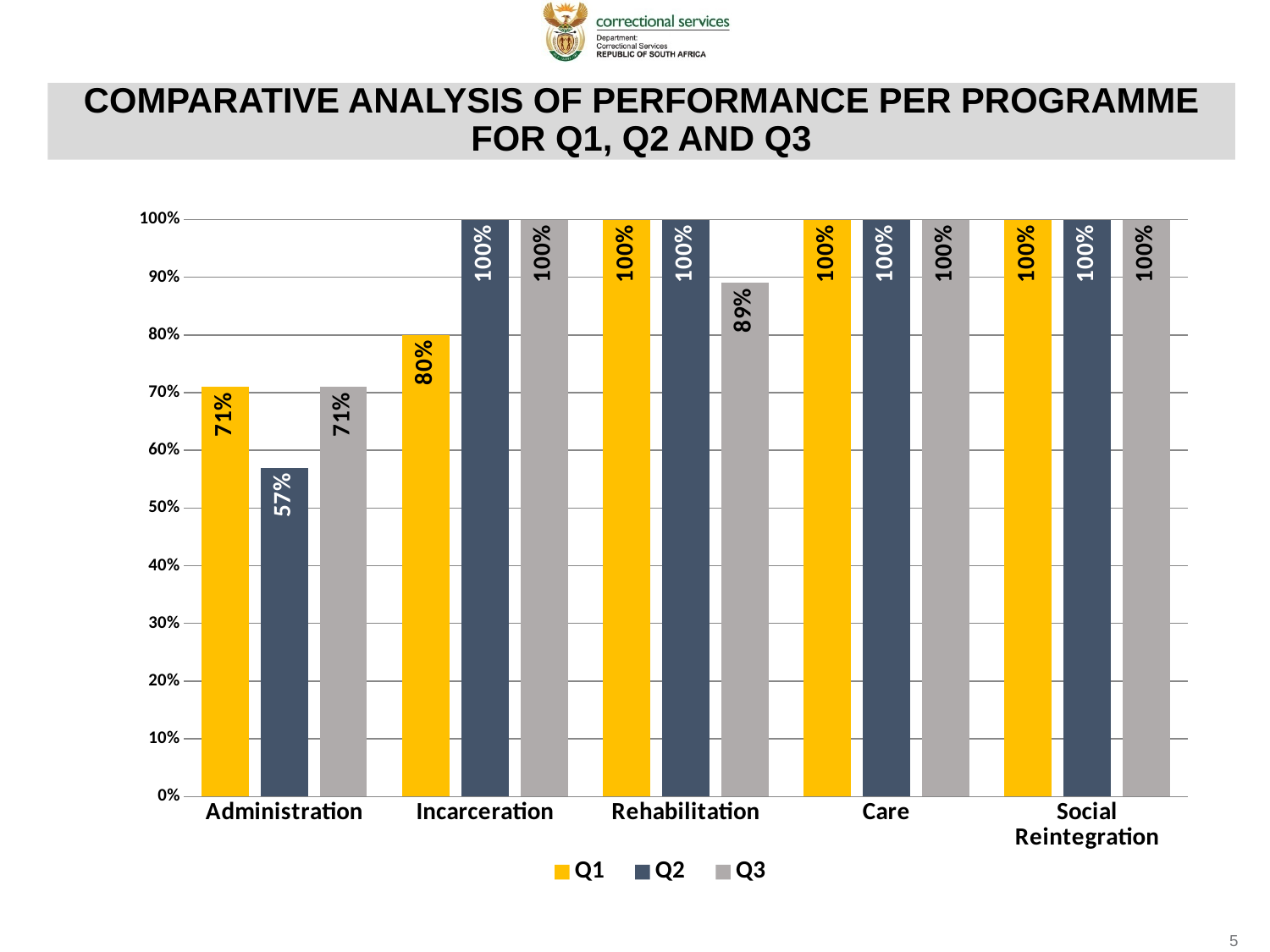
How many series does the legend list? 3 Which is larger, the Q1 value for Incarceration or the Q1 value for Administration? Incarceration Which programme has the lowest Q1 value? Administration Which programme has the lowest Q2 value? Administration What is the difference between the Q2 and Q3 values for Rehabilitation? 11% What is the Q2 value for Administration? 57% What is the Q1 value for Incarceration? 80% How many programmes are shown on the x axis? 5 What is the difference between the Q1 and Q2 values for Administration? 14% What is the Q3 value for Administration? 71% What is the Q3 value for Rehabilitation? 89% What kind of chart is shown on the slide? Bar chart